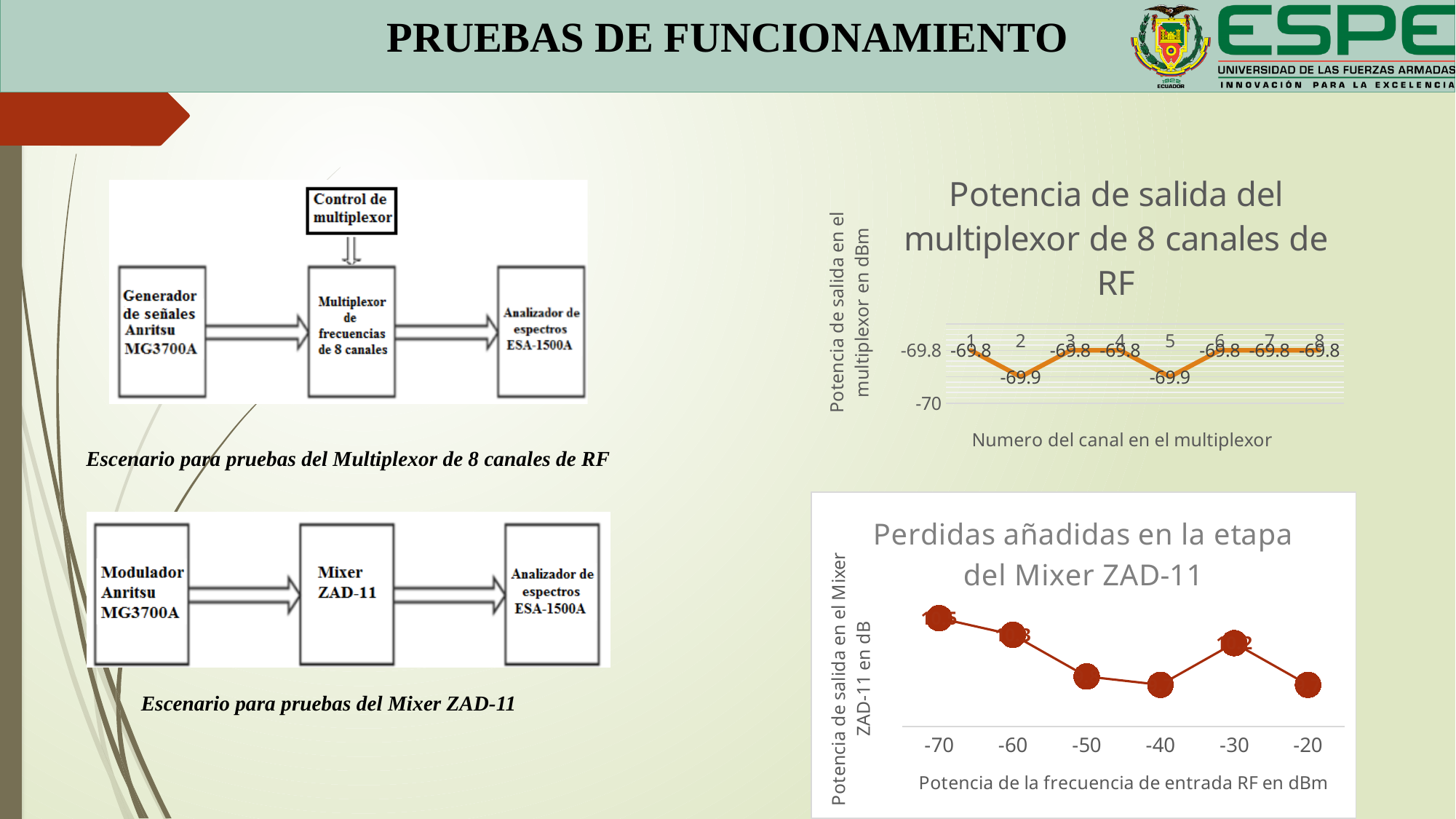
In the chart 'Potencia de salida del multiplexor de 8 canales de RF', what is the x-axis title? Numero del canal en el multiplexor In the chart 'Perdidas añadidas en la etapa del Mixer ZAD-11', what kind of chart is shown? line chart In the chart 'Potencia de salida del multiplexor de 8 canales de RF', what is the output power for channel 2? -69.9 In the chart 'Potencia de salida del multiplexor de 8 canales de RF', what is the difference between the values for channel 1 and channel 2? 0.1 In the chart 'Potencia de salida del multiplexor de 8 canales de RF', how many channels are plotted? 8 In the chart 'Potencia de salida del multiplexor de 8 canales de RF', what is the output power for channel 8? -69.8 In the chart 'Potencia de salida del multiplexor de 8 canales de RF', what kind of chart is shown? line chart In the chart 'Perdidas añadidas en la etapa del Mixer ZAD-11', how many data points are plotted? 6 In the chart 'Perdidas añadidas en la etapa del Mixer ZAD-11', which is higher, the value at -70 or the value at -40? -70 In the chart 'Potencia de salida del multiplexor de 8 canales de RF', what is the output power for channel 5? -69.9 In the chart 'Potencia de salida del multiplexor de 8 canales de RF', which is larger, the value for channel 3 or channel 5? channel 3 In the chart 'Perdidas añadidas en la etapa del Mixer ZAD-11', what is the x-axis title? Potencia de la frecuencia de entrada RF en dBm